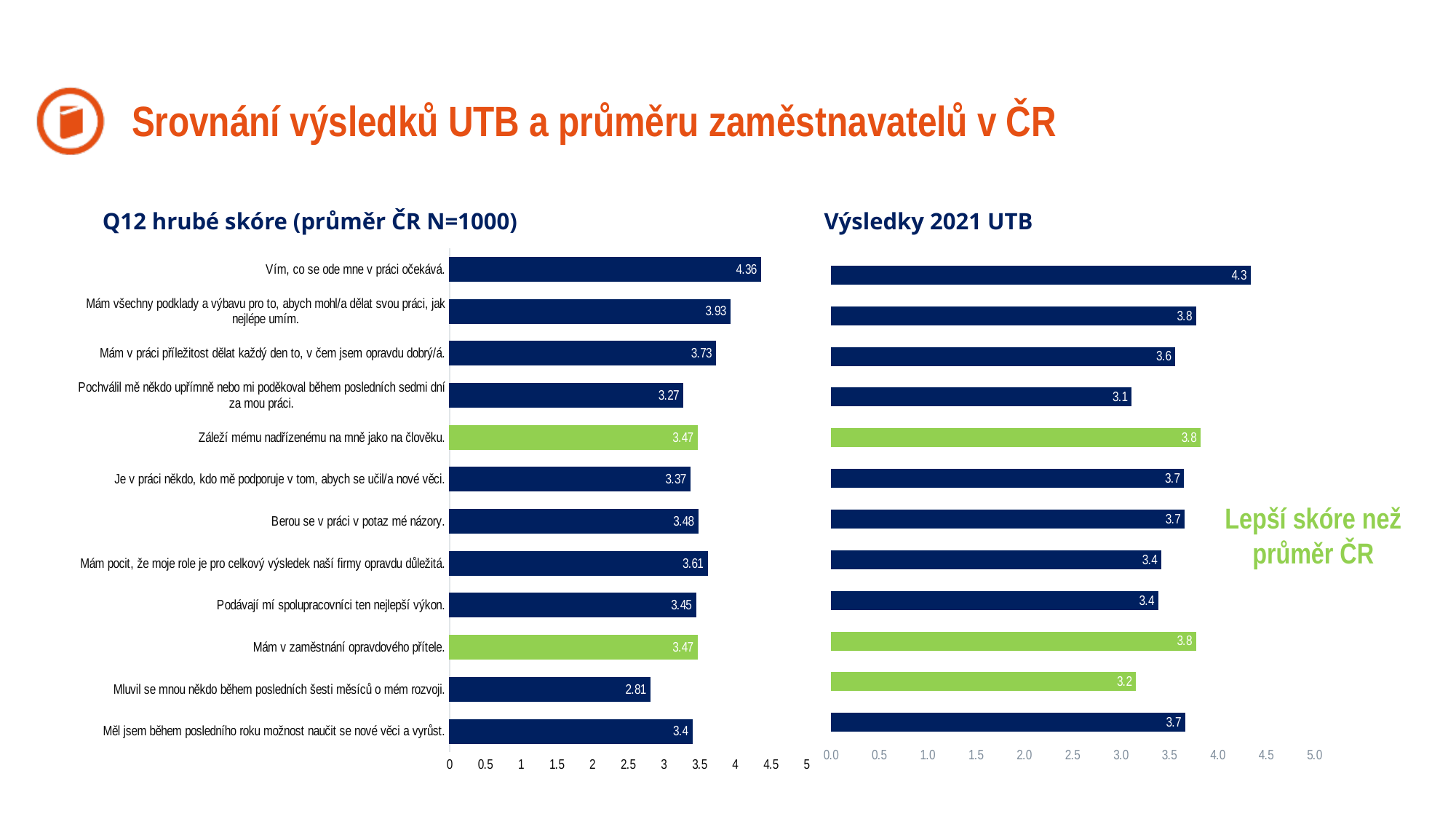
In the chart titled "Výsledky 2021 UTB", which is larger: the value for "Mám v zaměstnání opravdového přítele." or for "Podávají mí spolupracovníci ten nejlepší výkon."? Mám v zaměstnání opravdového přítele. In the chart titled "Q12 hrubé skóre (průměr ČR N=1000)", what is the difference between the values for "Vím, co se ode mne v práci očekává." and "Mluvil se mnou někdo během posledních šesti měsíců o mém rozvoji."? 1.55 In the chart titled "Výsledky 2021 UTB", which category has the highest value? Vím, co se ode mne v práci očekává. How many categories are shown in the chart titled "Q12 hrubé skóre (průměr ČR N=1000)"? 12 What kind of chart is the chart titled "Výsledky 2021 UTB"? Bar chart In the chart titled "Q12 hrubé skóre (průměr ČR N=1000)", which category has the lowest value? Mluvil se mnou někdo během posledních šesti měsíců o mém rozvoji. In the chart titled "Výsledky 2021 UTB", how many bars are coloured green? 3 In the chart titled "Q12 hrubé skóre (průměr ČR N=1000)", what is the value for "Mám v práci příležitost dělat každý den to, v čem jsem opravdu dobrý/á."? 3.73 In the chart titled "Výsledky 2021 UTB", what is the difference between the values for "Vím, co se ode mne v práci očekává." and "Pochválil mě někdo upřímně nebo mi poděkoval během posledních sedmi dní za mou práci."? 1.2 In the chart titled "Výsledky 2021 UTB", what is the value for "Mluvil se mnou někdo během posledních šesti měsíců o mém rozvoji."? 3.2 In the chart titled "Q12 hrubé skóre (průměr ČR N=1000)", what is the value for "Vím, co se ode mne v práci očekává."? 4.36 In the chart titled "Q12 hrubé skóre (průměr ČR N=1000)", which is larger: the value for "Mám pocit, že moje role je pro celkový výsledek naší firmy opravdu důležitá." or for "Pochválil mě někdo upřímně nebo mi poděkoval během posledních sedmi dní za mou práci."? Mám pocit, že moje role je pro celkový výsledek naší firmy opravdu důležitá.